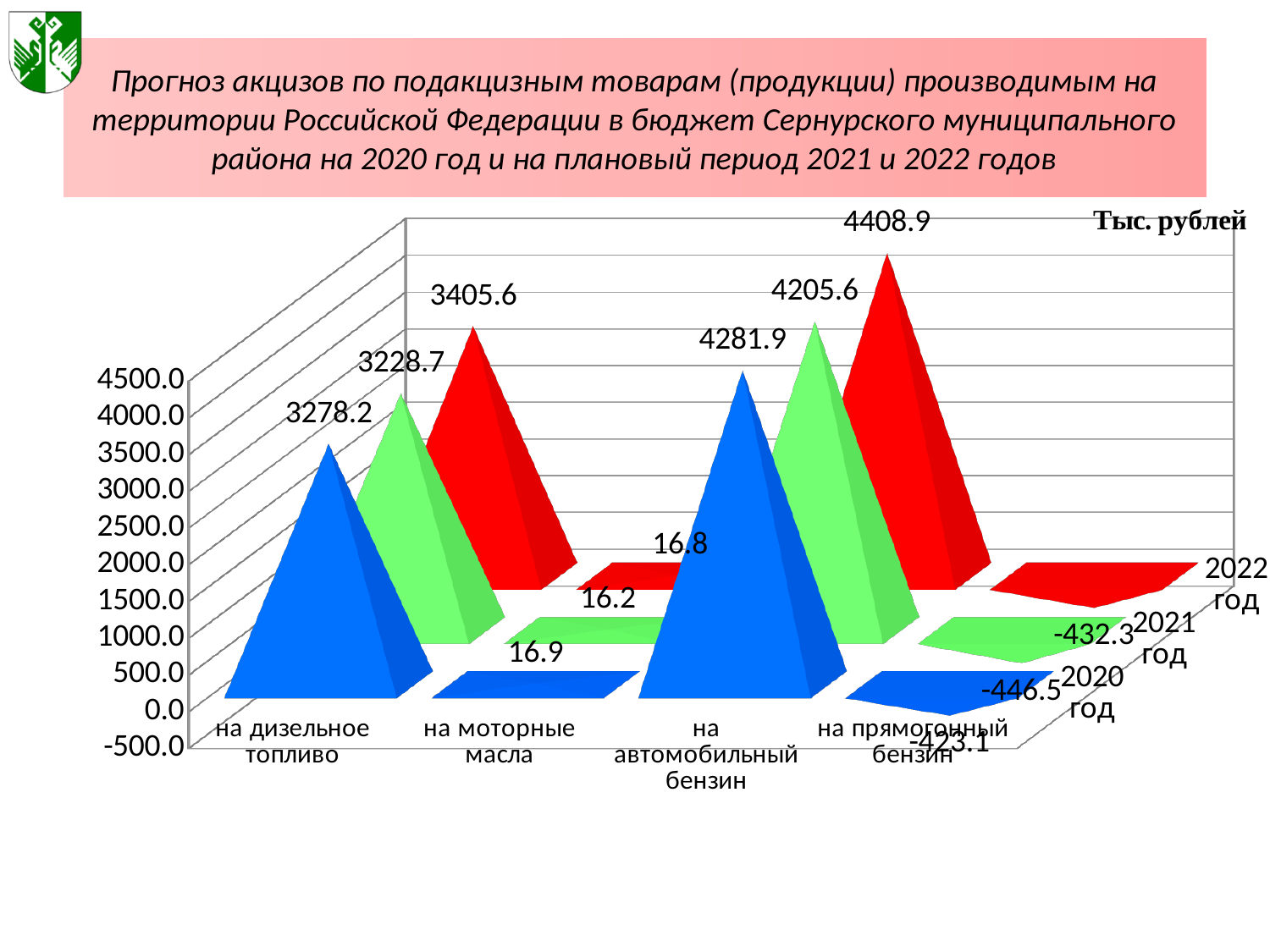
What is the value for «на дизельное топливо» in 2020 год? 3278.2 What unit of measurement is indicated on the chart? Тыс. рублей How many series (years) does the chart show? 3 Which category has the lowest value in 2020 год? на прямогонный бензин What is the difference between the 2022 год and 2020 год values for «на автомобильный бензин»? 127.0 What is the difference between the 2022 год and 2021 год values for «на дизельное топливо»? 176.9 For «на дизельное топливо», which year has the larger value, 2020 год or 2021 год? 2020 год What is the value for «на автомобильный бензин» in 2022 год? 4408.9 Which category has the highest value in 2022 год? на автомобильный бензин How many categories are shown on the x axis of the chart? 4 What is the value for «на моторные масла» in 2021 год? 16.2 What is the value for «на дизельное топливо» in 2022 год? 3405.6